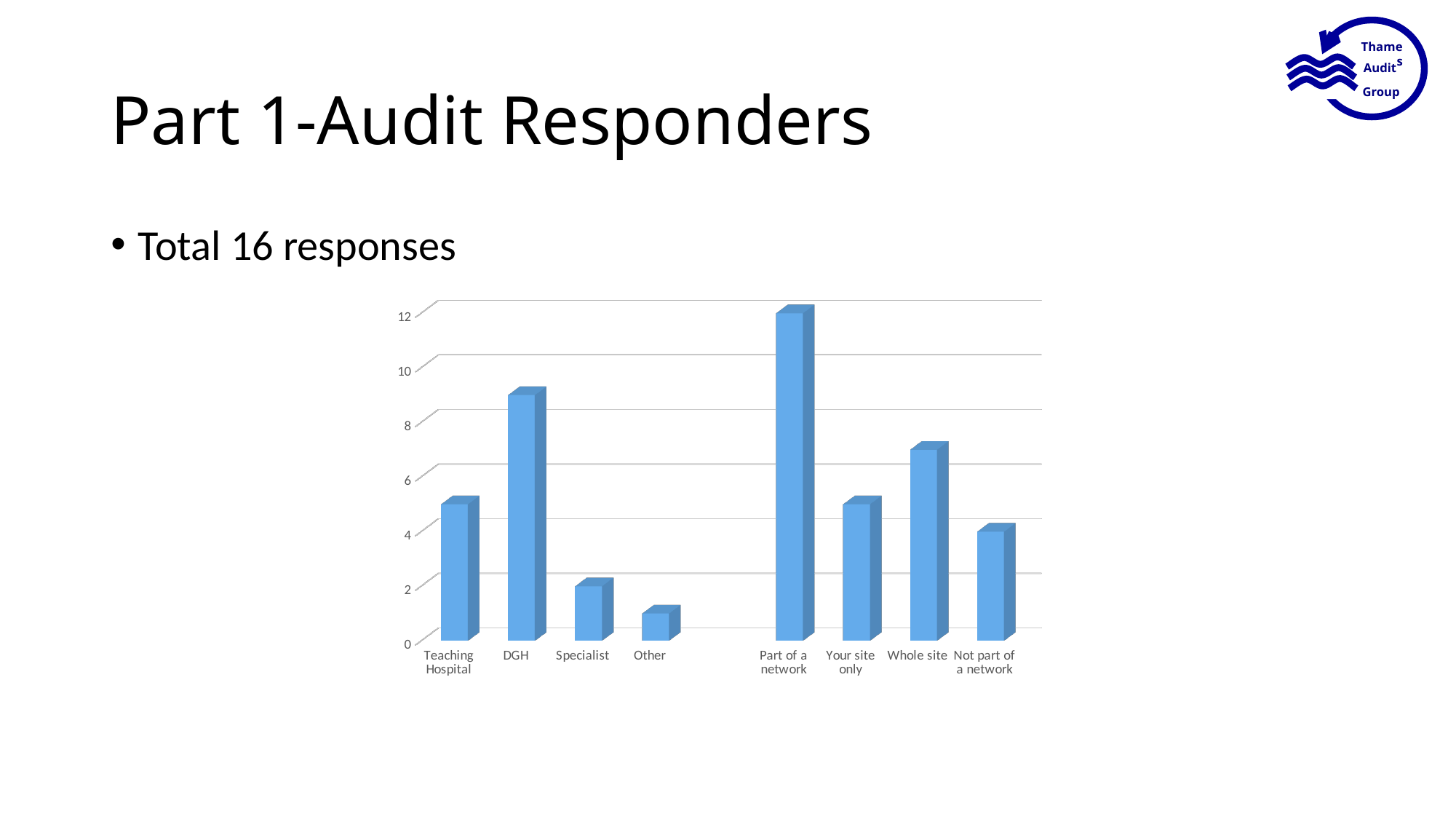
Is the value for Other greater or less than 2? less Is the value for Not part of a network greater or less than 6? less Is the value for Specialist greater or less than 4? less Which is larger, the value for Whole site or the value for Your site only? Whole site What colour are the bars in the chart? blue Which category has the highest bar in the chart? Part of a network Which is larger, the value for DGH or the value for Teaching Hospital? DGH How many labelled categories are shown on the x axis of the chart? 8 Which category has the lowest bar in the chart? Other What kind of chart is shown on the slide? bar chart